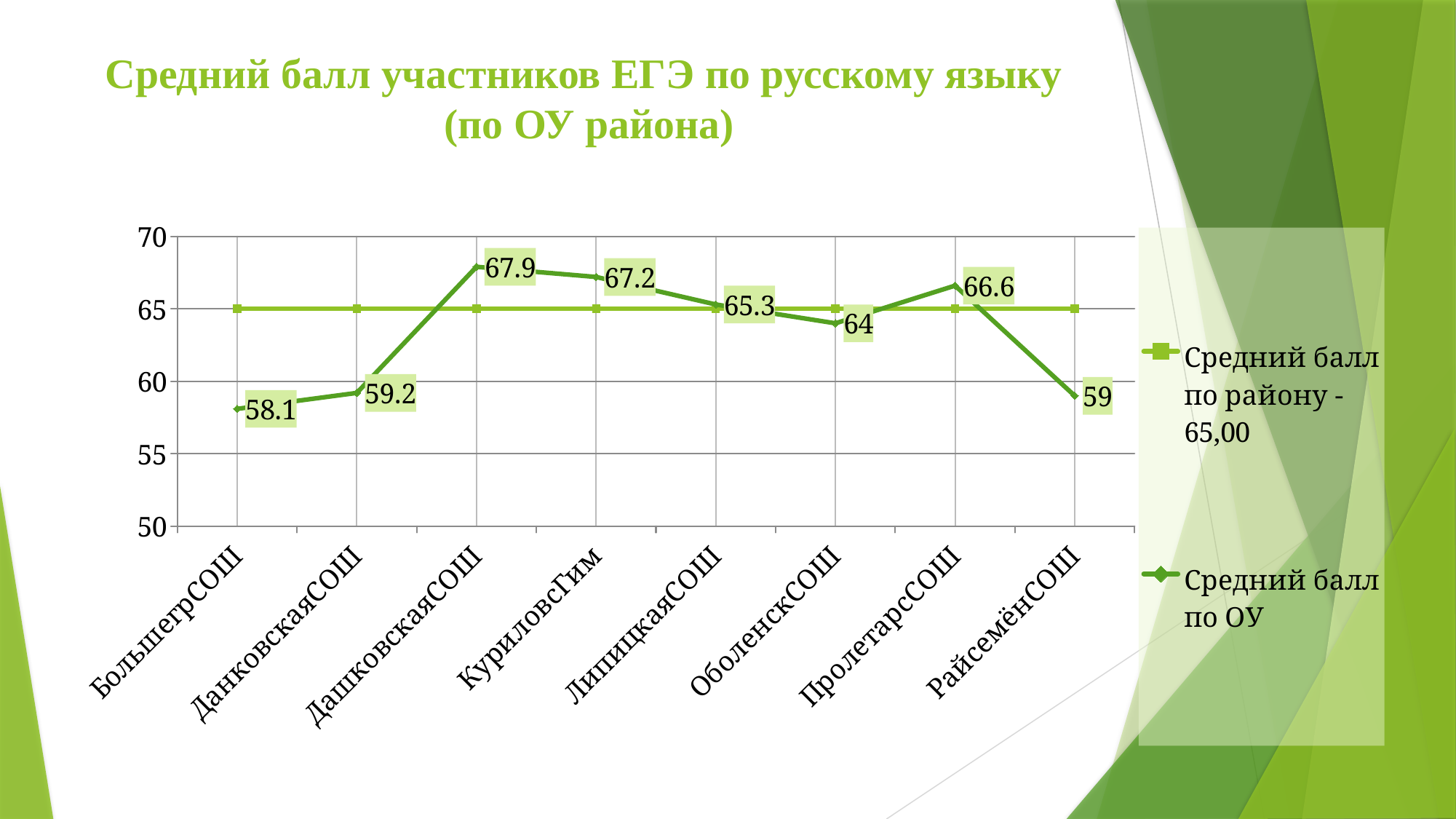
What is the average score (Средний балл по ОУ) for ОболенскСОШ? 64 Which school has the highest average score in the Средний балл по ОУ series? ДашковскаяСОШ What is the difference between the average scores of ДашковскаяСОШ and ДанковскаяСОШ? 8.7 What is the average score (Средний балл по ОУ) for БольшегрСОШ? 58.1 How many series does the chart legend list? 2 Which school has the lowest average score in the Средний балл по ОУ series? БольшегрСОШ How many schools are shown on the x axis of the chart? 8 What is the average score (Средний балл по ОУ) for ДашковскаяСОШ? 67.9 What is the average score (Средний балл по ОУ) for РайсемёнСОШ? 59 Which has a higher average score, КуриловсГим or ПролетарсСОШ? КуриловсГим Is the average score for ЛипицкаяСОШ greater or less than 60? greater What type of chart is shown on the slide? line chart